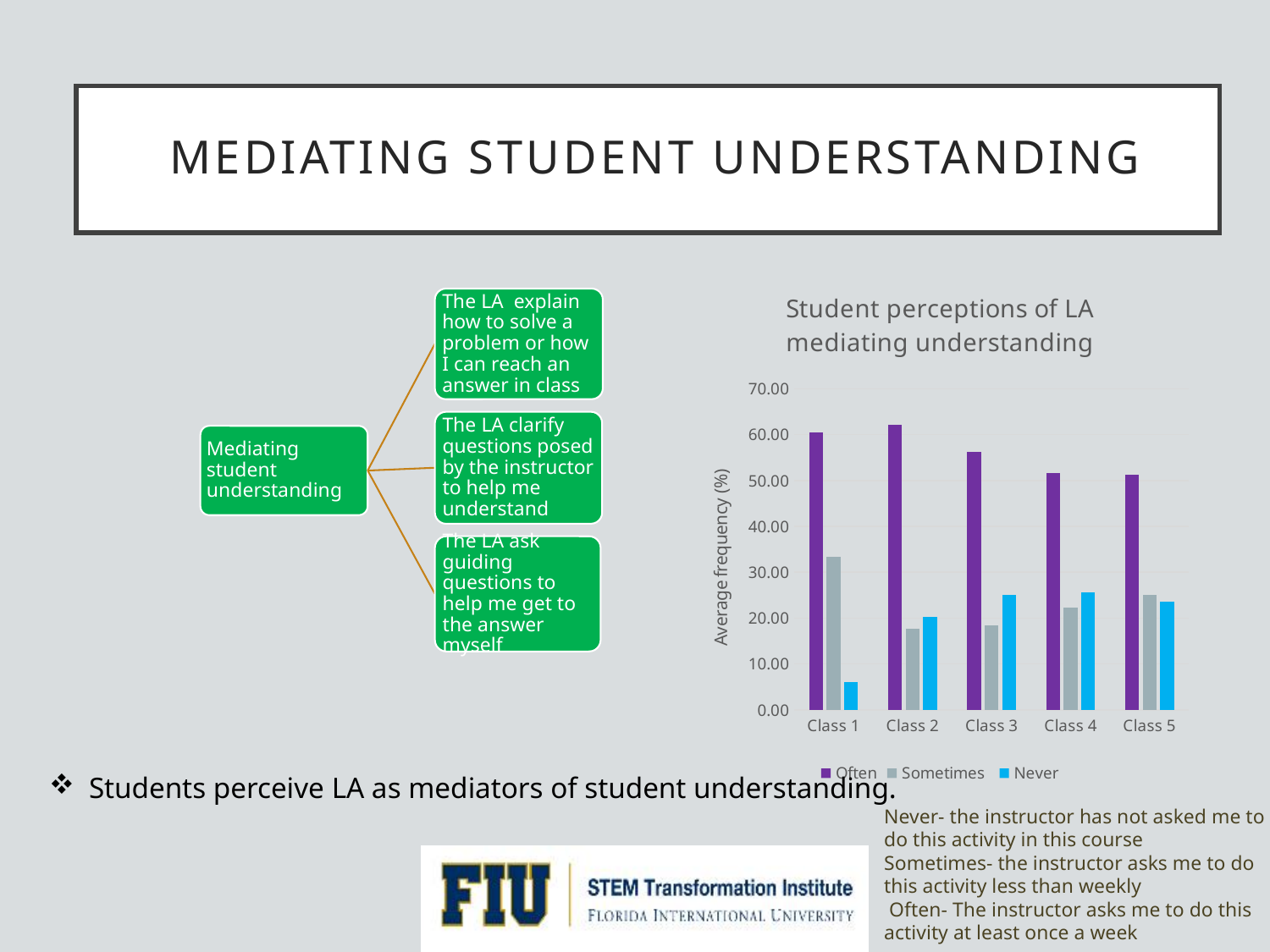
Is the Never value for Class 1 greater or less than 10.00? less Which class has the highest value for the Sometimes series? Class 1 For Class 1, which is larger: the Sometimes value or the Never value? Sometimes For Class 3, which is larger: the Sometimes value or the Never value? Never How many series does the chart's legend list? 3 Is the Often value for Class 1 greater or less than 50.00? greater Which class has the lowest value for the Never series? Class 1 Is the Sometimes value for Class 2 greater or less than 20.00? less What is the label on the vertical axis of the chart? Average frequency (%) What kind of chart is shown on the slide? bar chart How many classes are shown on the x axis of the chart? 5 What is the title of the chart? Student perceptions of LA mediating understanding